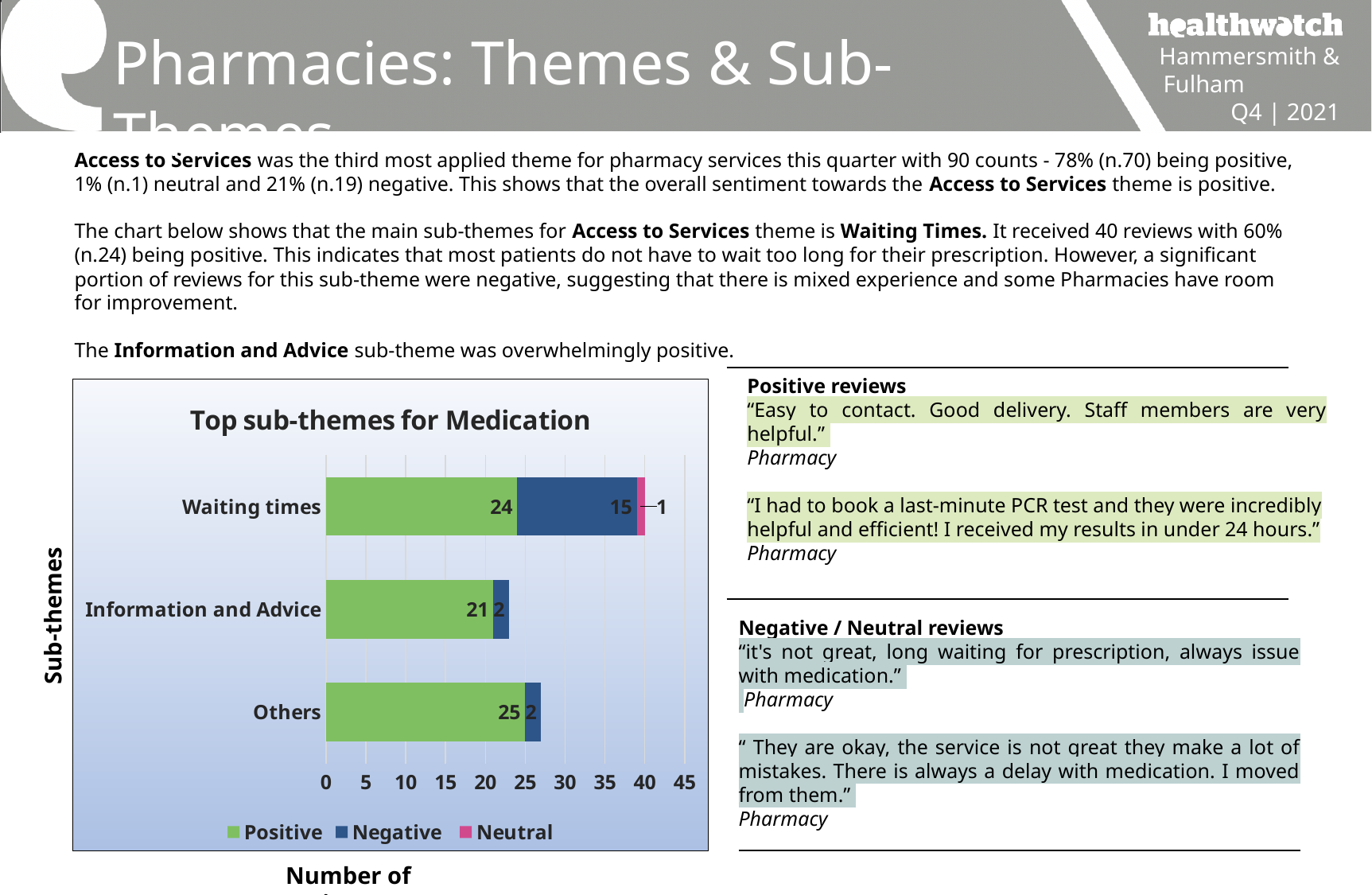
How many series does the legend list? 3 What is the Negative value for Others? 2 How many sub-themes are shown on the chart? 3 What is the Negative value for Waiting times? 15 Which sub-theme has the highest Positive value? Others What is the Neutral value for Waiting times? 1 What is the difference between the Positive and Negative values for Waiting times? 9 What is the Positive value for Information and Advice? 21 What is the Positive value for Waiting times? 24 What is the total of the stacked bar for Waiting times? 40 What is the total of the stacked bar for Information and Advice? 23 Which sub-theme has the highest Negative value? Waiting times